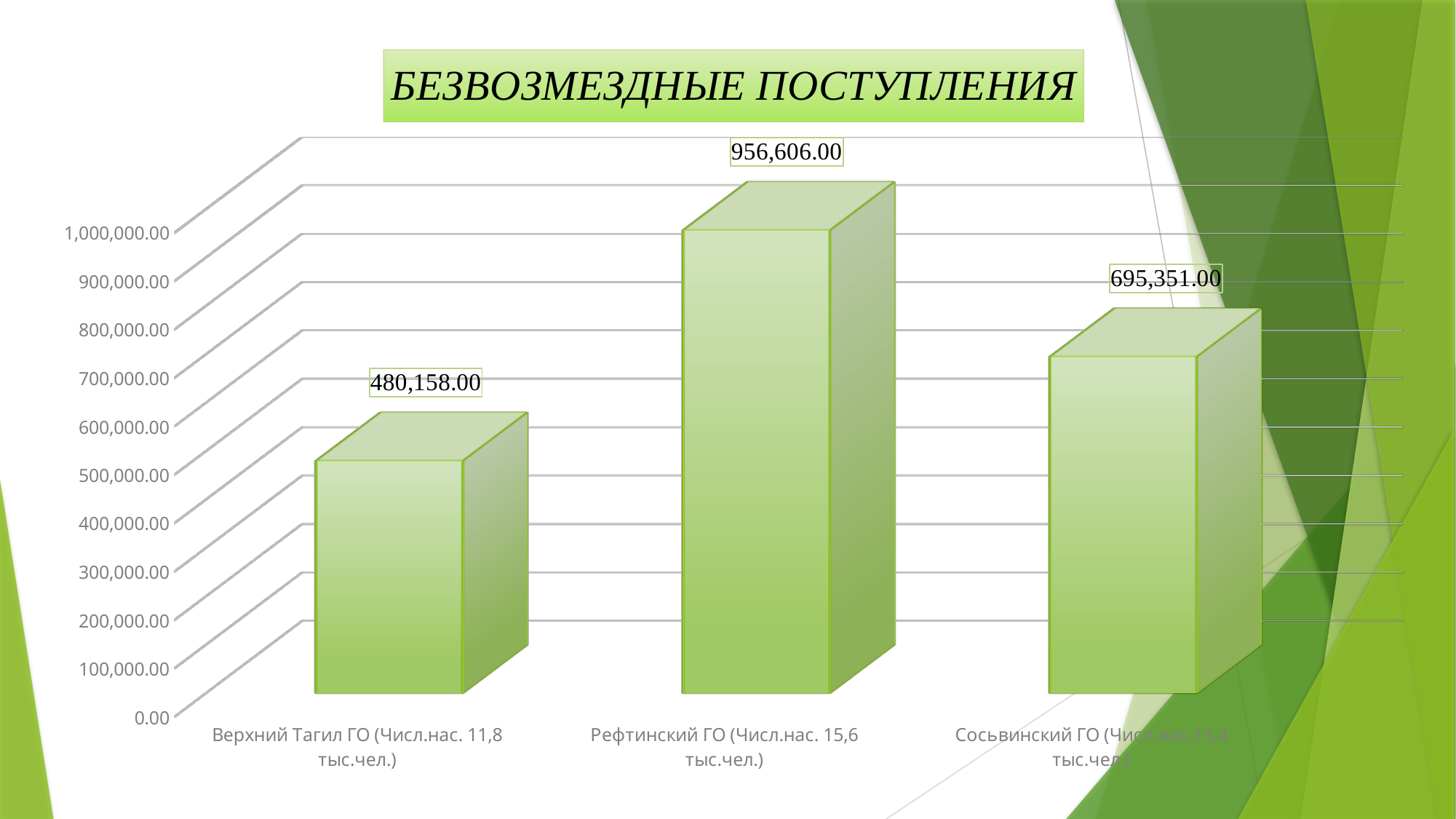
What kind of chart is shown on the slide? bar chart Is the value for Рефтинский ГО greater or less than 900,000.00? greater What is the difference between the values for Рефтинский ГО and Верхний Тагил ГО? 476,448.00 Which category has the highest value? Рефтинский ГО Which is larger, the value for Сосьвинский ГО or the value for Верхний Тагил ГО? Сосьвинский ГО What is the title of the chart? БЕЗВОЗМЕЗДНЫЕ ПОСТУПЛЕНИЯ What is the value for Сосьвинский ГО? 695,351.00 What is the value for Верхний Тагил ГО? 480,158.00 How many categories are shown in the chart? 3 Which category has the lowest value? Верхний Тагил ГО What is the value for Рефтинский ГО? 956,606.00 What is the difference between the values for Сосьвинский ГО and Верхний Тагил ГО? 215,193.00